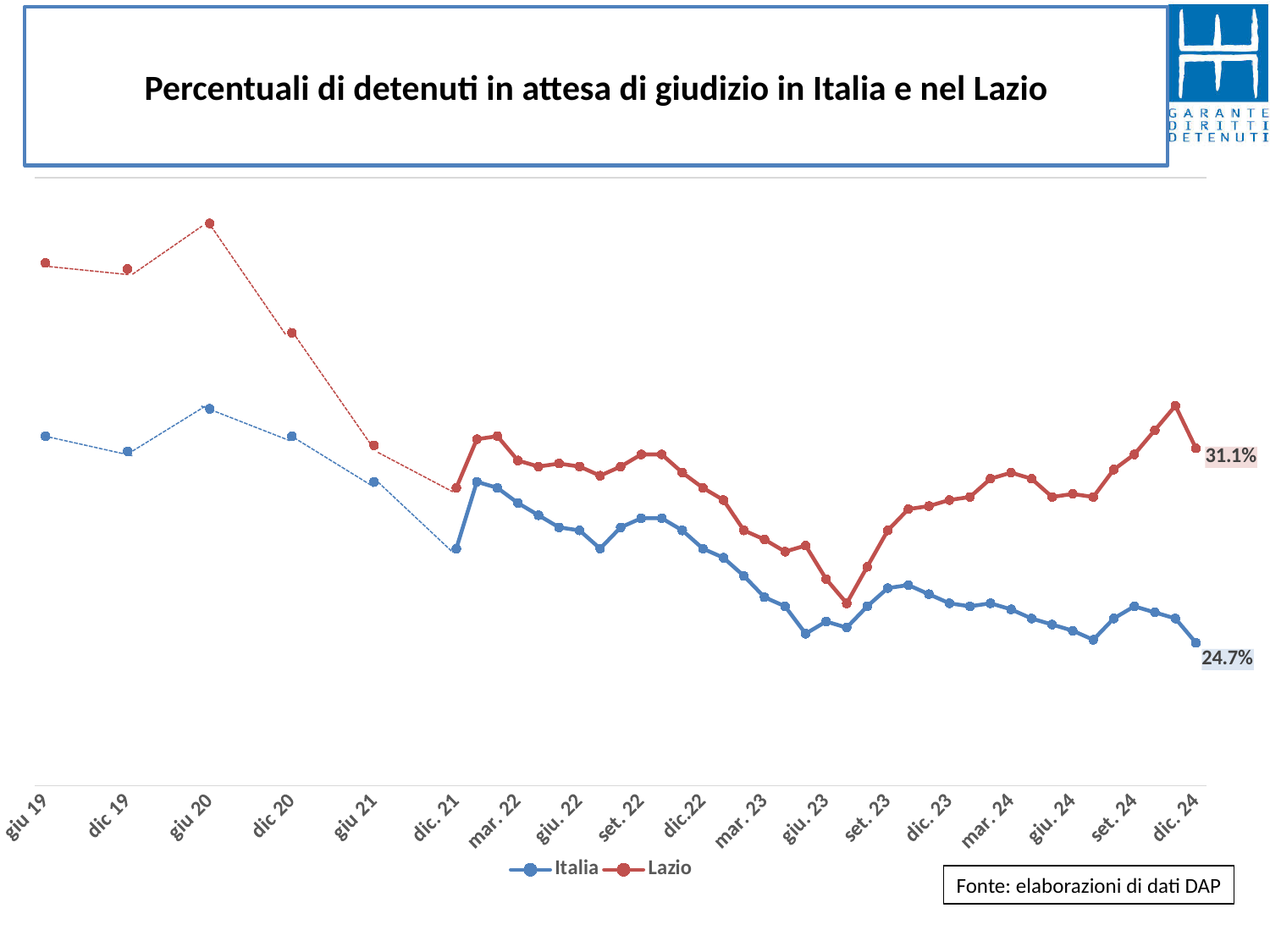
At which date does the Italia series reach its highest value? giu 20 What is the title of the chart? Percentuali di detenuti in attesa di giudizio in Italia e nel Lazio What is the difference between the Lazio and Italia values at dic. 24? 6.4 percentage points What is the value for Lazio at dic. 24? 31.1% How many series does the legend list? 2 Does the Lazio series rise or fall between giu 20 and dic. 21? Fall At which date does the Lazio series reach its highest value? giu 20 What kind of chart is shown on the slide? Line chart What is the value for Italia at dic. 24? 24.7% Which colour is used for the Lazio series? Red At dic. 24, which series has the larger value, Italia or Lazio? Lazio